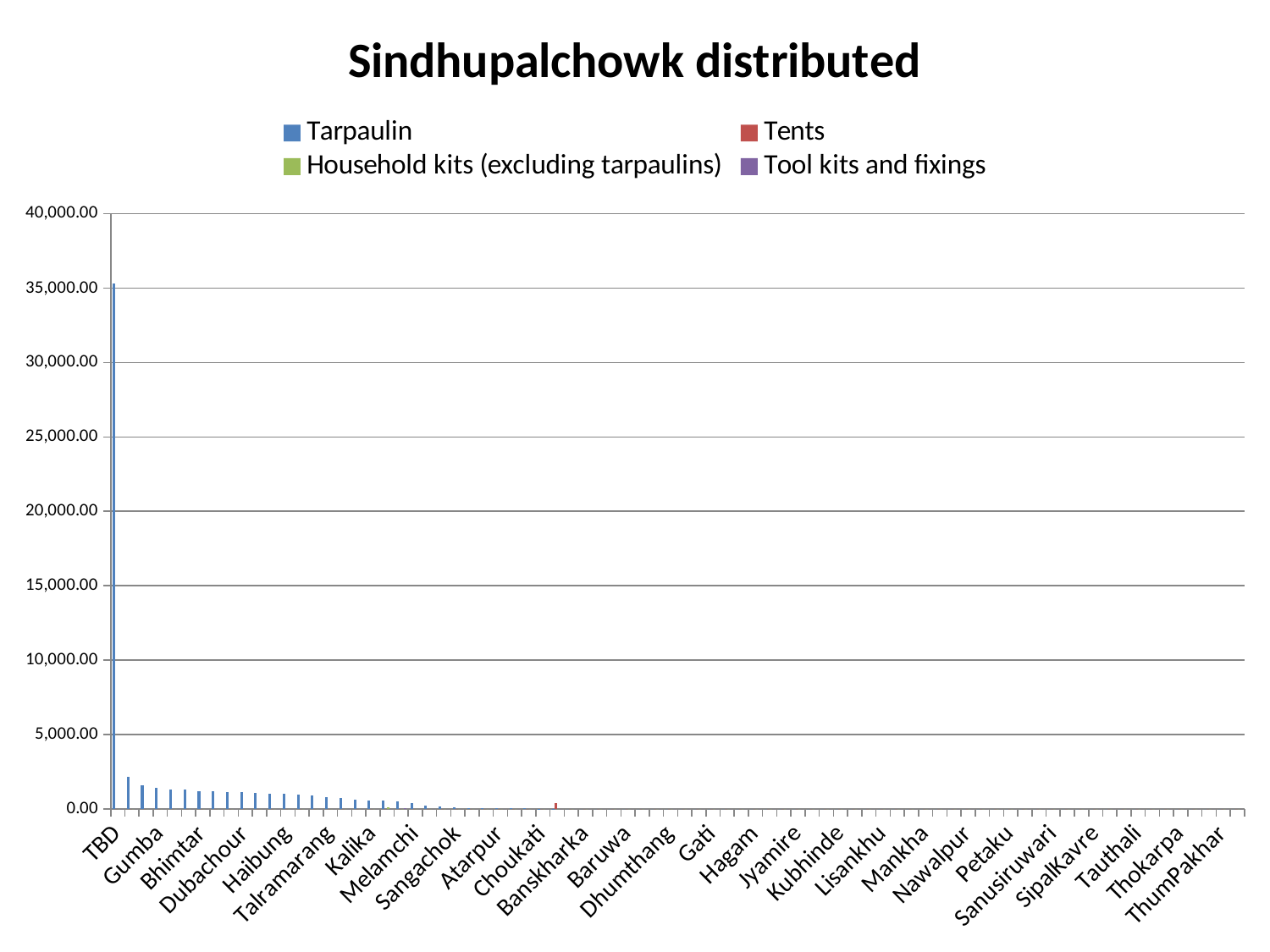
What is the title of the chart? Sindhupalchowk distributed What kind of chart is shown on the slide? bar chart Which legend entry is shown in blue? Tarpaulin Which has the larger Tarpaulin value, Gumba or Melamchi? Gumba Is the Tarpaulin value for TBD greater or less than 30,000.00? greater Which has the larger Tarpaulin value, TBD or Gumba? TBD Which category has the highest Tarpaulin value? TBD Is the Tarpaulin value for Gumba greater or less than 5,000.00? less Is the Tarpaulin value for TBD greater or less than 40,000.00? less How many series does the legend list? 4 Do the Tarpaulin values generally rise or fall from left to right along the x axis? fall What is the highest value shown on the vertical axis? 40,000.00